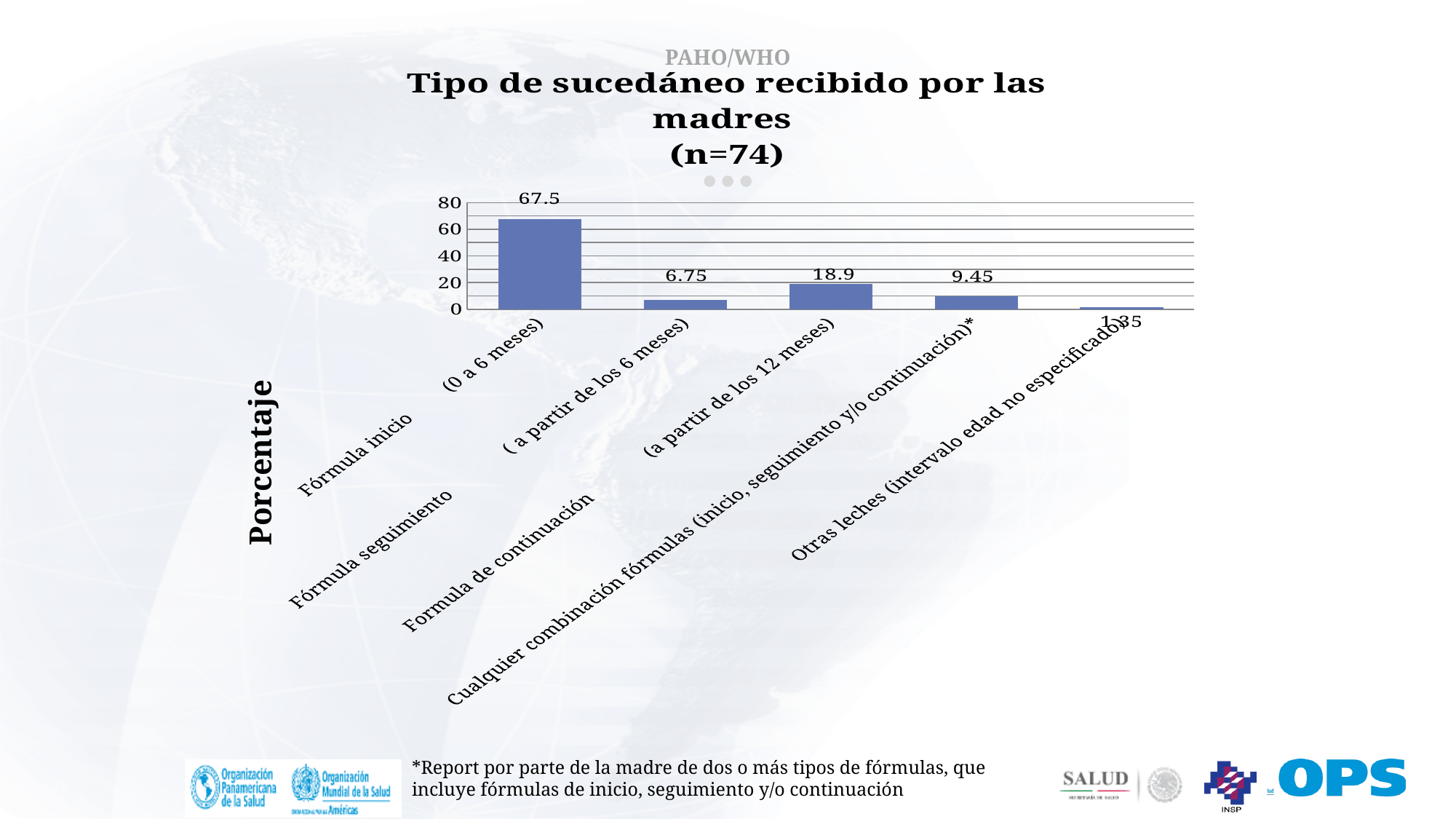
What is the difference between the values for Fórmula inicio (0 a 6 meses) and Formula de continuación (a partir de los 12 meses)? 48.6 Which category has the lowest value? Otras leches (intervalo edad no especificado) Which category has the highest value? Fórmula inicio (0 a 6 meses) What is the label of the vertical axis? Porcentaje What is the value for Formula de continuación (a partir de los 12 meses)? 18.9 What is the value for Fórmula inicio (0 a 6 meses)? 67.5 Is the value for Otras leches (intervalo edad no especificado) greater or less than 20? less How many categories are shown in the chart? 5 What is the value for Fórmula seguimiento (a partir de los 6 meses)? 6.75 What is the value for Cualquier combinación fórmulas (inicio, seguimiento y/o continuación)*? 9.45 Which is larger, the value for Formula de continuación (a partir de los 12 meses) or the value for Cualquier combinación fórmulas? Formula de continuación (a partir de los 12 meses) What type of chart is shown on the slide? bar chart